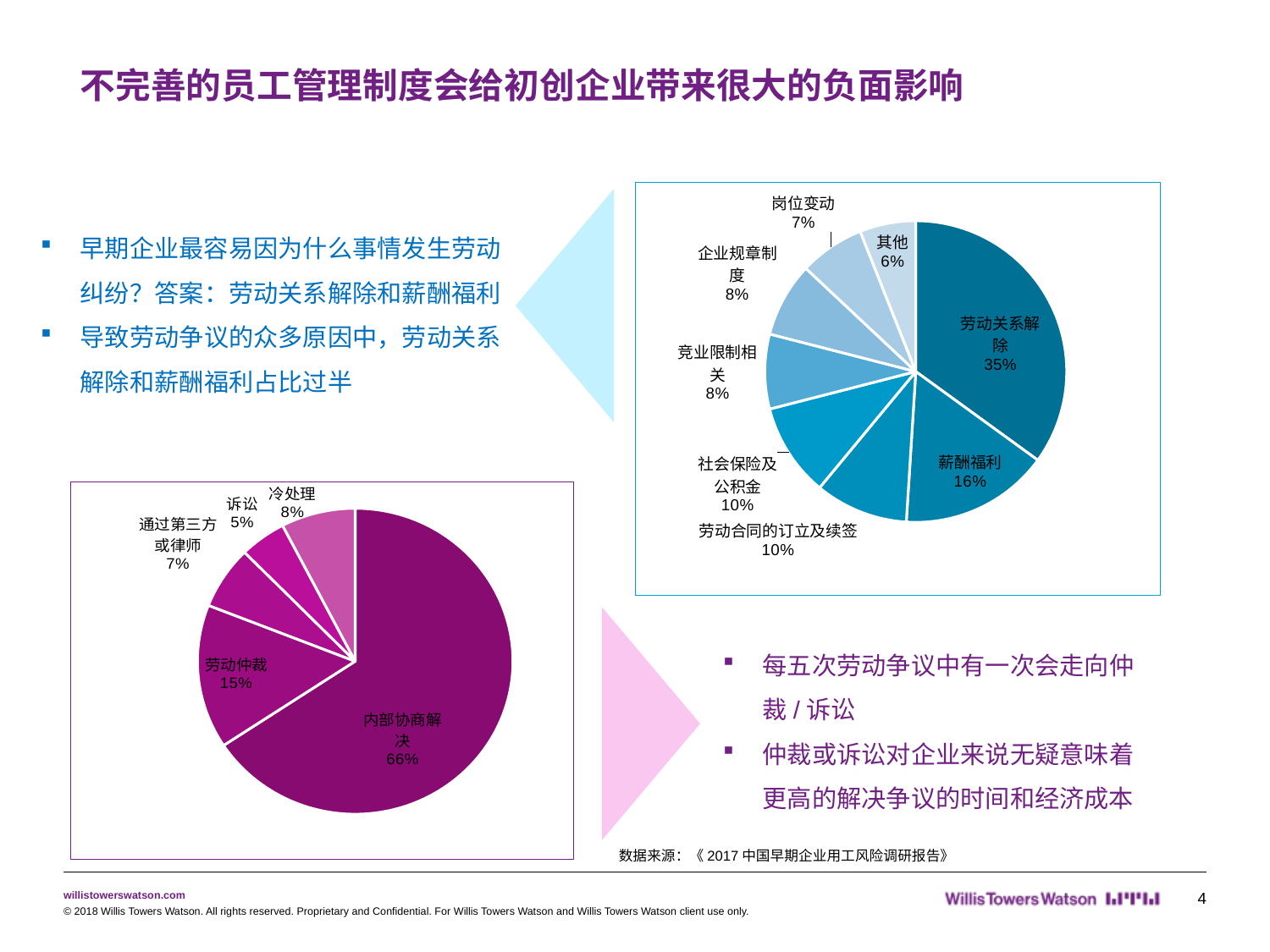
In the pie chart at the bottom left of the slide, which category has the smallest slice? 诉讼 In the pie chart at the top right of the slide, which category has the largest slice? 劳动关系解除 In the pie chart at the top right of the slide, how many slices are there? 8 In the pie chart at the bottom left of the slide, what share is labelled for 内部协商解决? 66% What kind of chart is shown at the bottom left of the slide? Pie chart In the pie chart at the bottom left of the slide, what share is labelled for 劳动仲裁? 15% In the pie chart at the top right of the slide, what is the difference between the shares for 劳动关系解除 and 薪酬福利? 19% In the pie chart at the top right of the slide, what share is labelled for 劳动关系解除? 35% In the pie chart at the top right of the slide, which category has the smallest slice? 其他 In the pie chart at the bottom left of the slide, which is larger, the share for 冷处理 or the share for 通过第三方或律师? 冷处理 In the pie chart at the bottom left of the slide, how many slices are there? 5 In the pie chart at the top right of the slide, what share is labelled for 薪酬福利? 16%